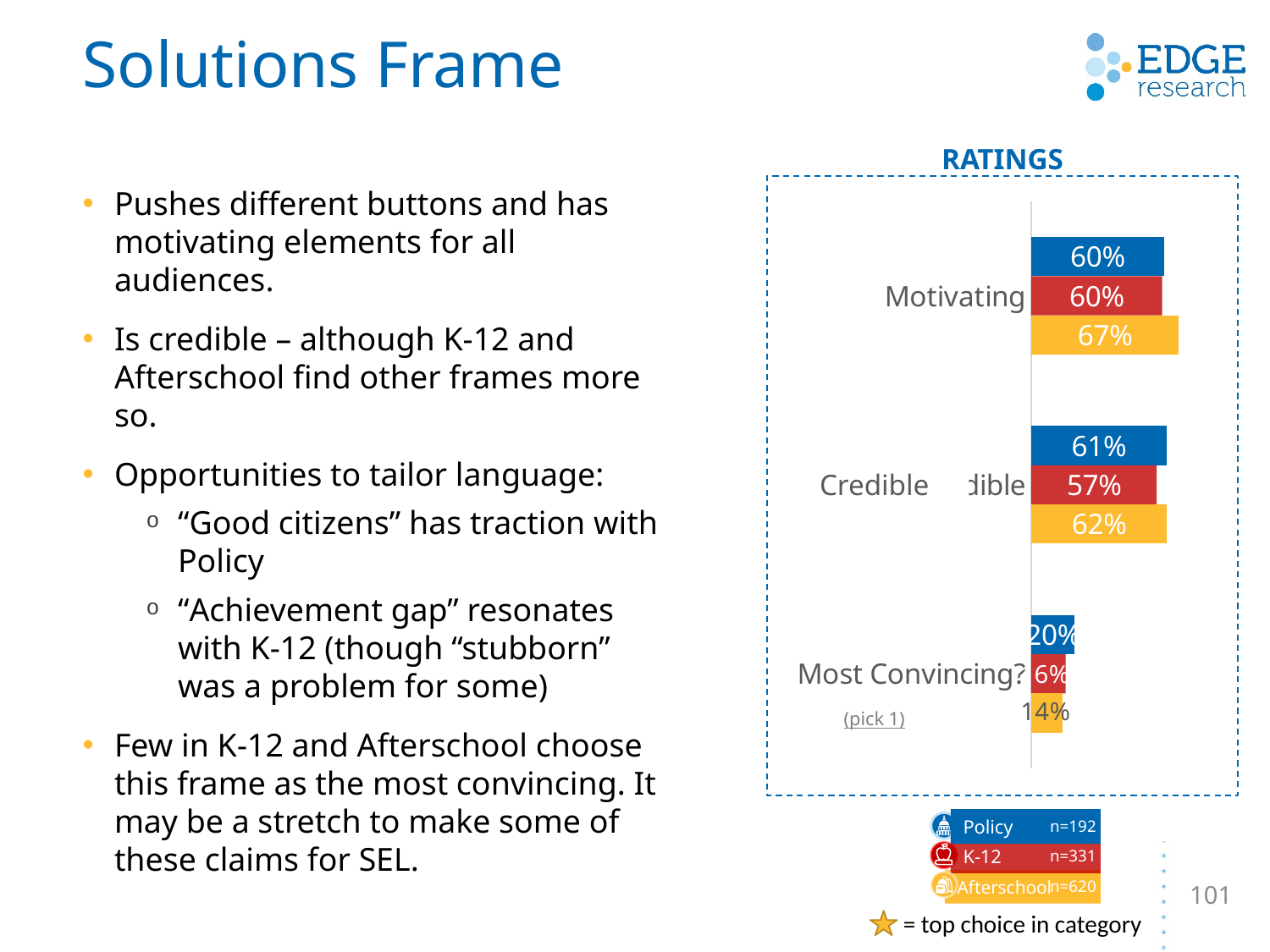
What is the difference between the Afterschool and Policy values for Motivating? 7% What is the Afterschool value for Motivating? 67% What is the Policy value for Most Convincing? 20% What sample size (n) does the legend give for Afterschool? n=620 How many rating categories are shown on the chart? 3 What kind of chart is shown under the RATINGS heading? bar chart Which audience has the lowest value for Most Convincing? Afterschool How many series does the legend list? 3 What is the K-12 value for Credible? 57% Which audience has the highest value for Credible? Afterschool Which is larger for Credible, the Policy value or the K-12 value? Policy What is the K-12 value for Most Convincing? 16%